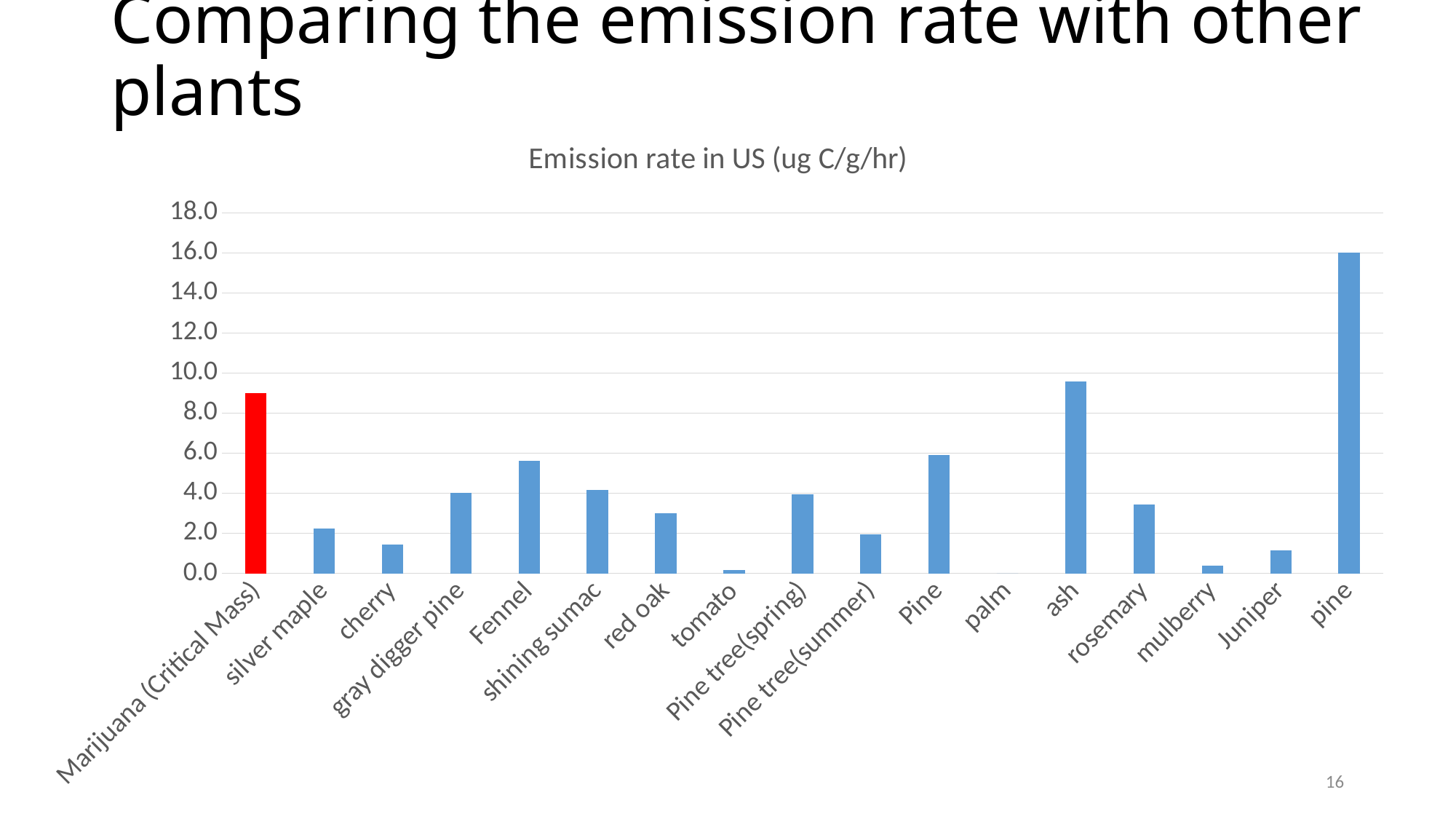
What kind of chart is shown on the slide? bar chart Is the value for Marijuana (Critical Mass) greater or less than 8.0? greater Which category's bar is coloured red? Marijuana (Critical Mass) Which has the larger emission rate, ash or Marijuana (Critical Mass)? ash Is the value for pine greater or less than 14.0? greater Which category has the highest emission rate? pine Is the value for cherry greater or less than 2.0? less Which has the larger emission rate, Pine tree(spring) or Pine tree(summer)? Pine tree(spring) How many plant categories are shown on the x axis? 17 What is the title of the chart? Emission rate in US (ug C/g/hr)